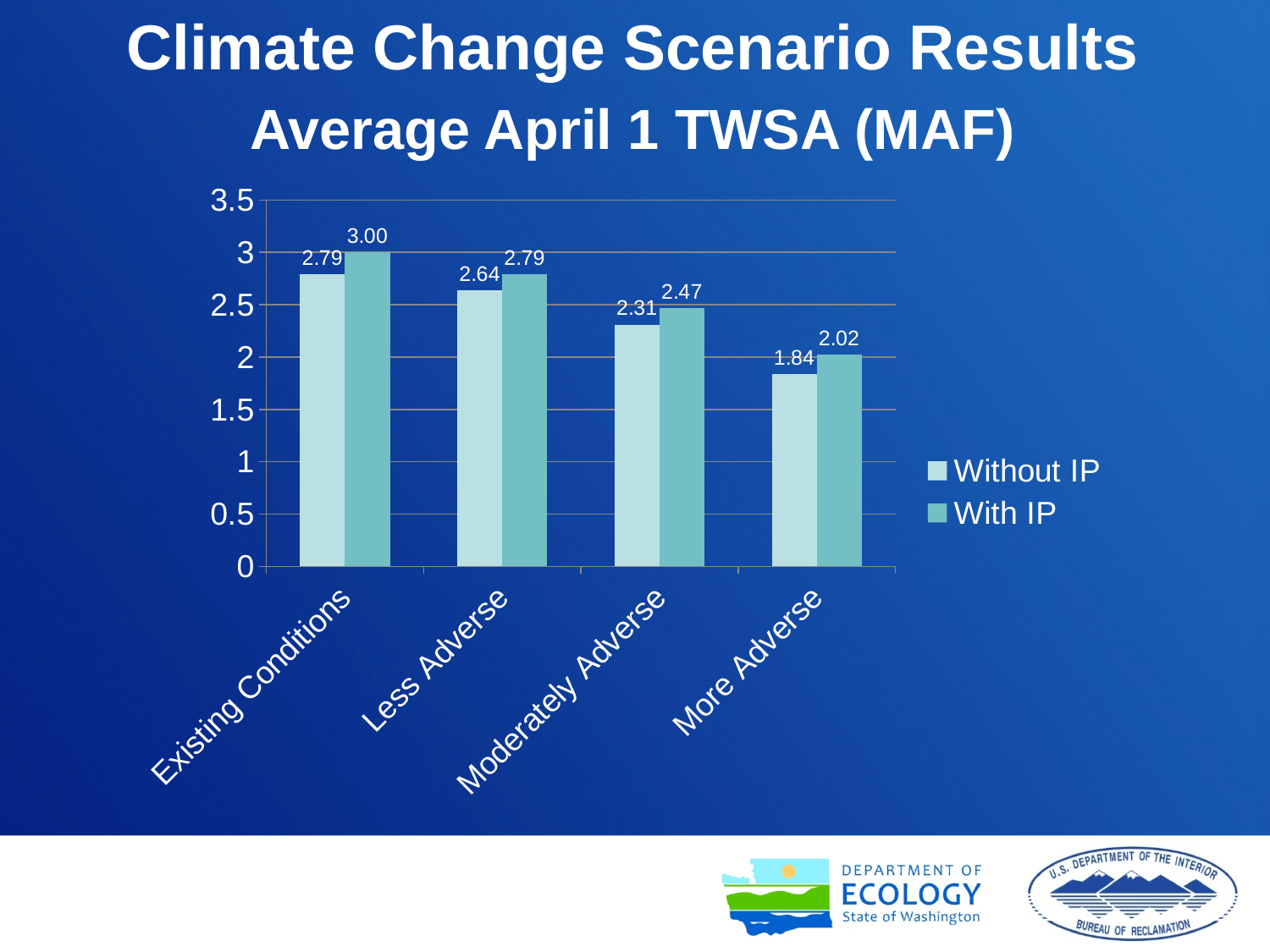
What is the Without IP value for Existing Conditions? 2.79 Which is larger for Moderately Adverse: the Without IP value or the With IP value? With IP Do the Without IP values rise or fall from Existing Conditions to More Adverse? fall What is the With IP value for More Adverse? 2.02 What is the With IP value for Moderately Adverse? 2.47 Which scenario has the lowest Without IP value? More Adverse What kind of chart is shown? bar chart Is the Without IP value for More Adverse greater or less than 2? less What is the difference between the With IP and Without IP values for Less Adverse? 0.15 Which scenario has the highest With IP value? Existing Conditions How many scenarios are shown on the x axis? 4 How many series does the legend list? 2